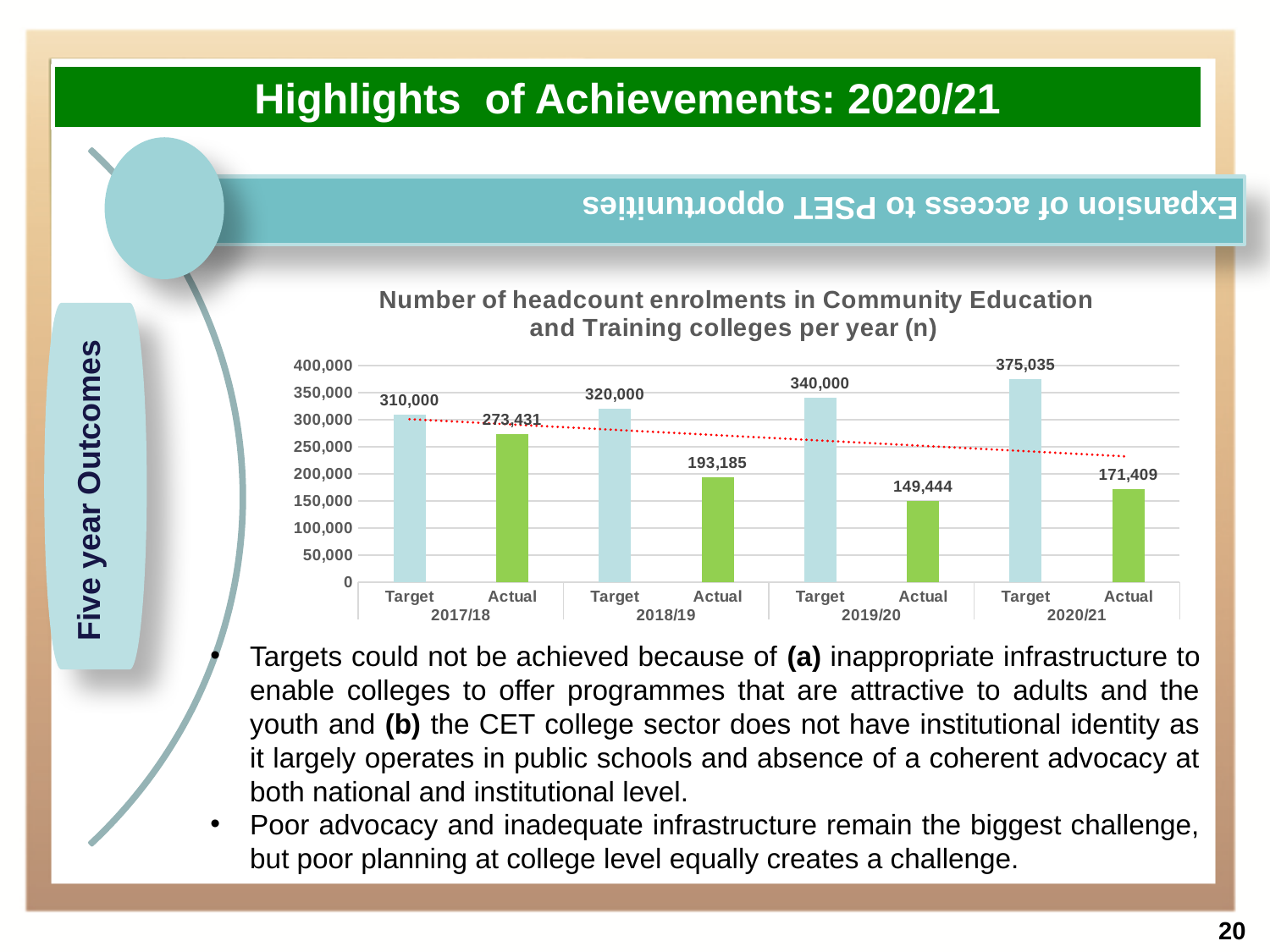
What is the Target value for 2018/19 in the chart? 320,000 What is the Target value for 2017/18 in the chart? 310,000 What is the Actual value for 2020/21 in the chart? 171,409 What is the difference between the Target and Actual values for 2017/18? 36,569 Which bar has the highest value in the chart? Target 2020/21 Do the Target values rise or fall from 2017/18 to 2020/21? Rise What kind of chart is shown on the slide? Bar chart What is the difference between the Target and Actual values for 2020/21? 203,626 Which is larger, the Actual value for 2018/19 or the Actual value for 2020/21? Actual 2018/19 Which bar has the lowest value in the chart? Actual 2019/20 What is the Actual value for 2019/20 in the chart? 149,444 How many bars are plotted in the chart? 8